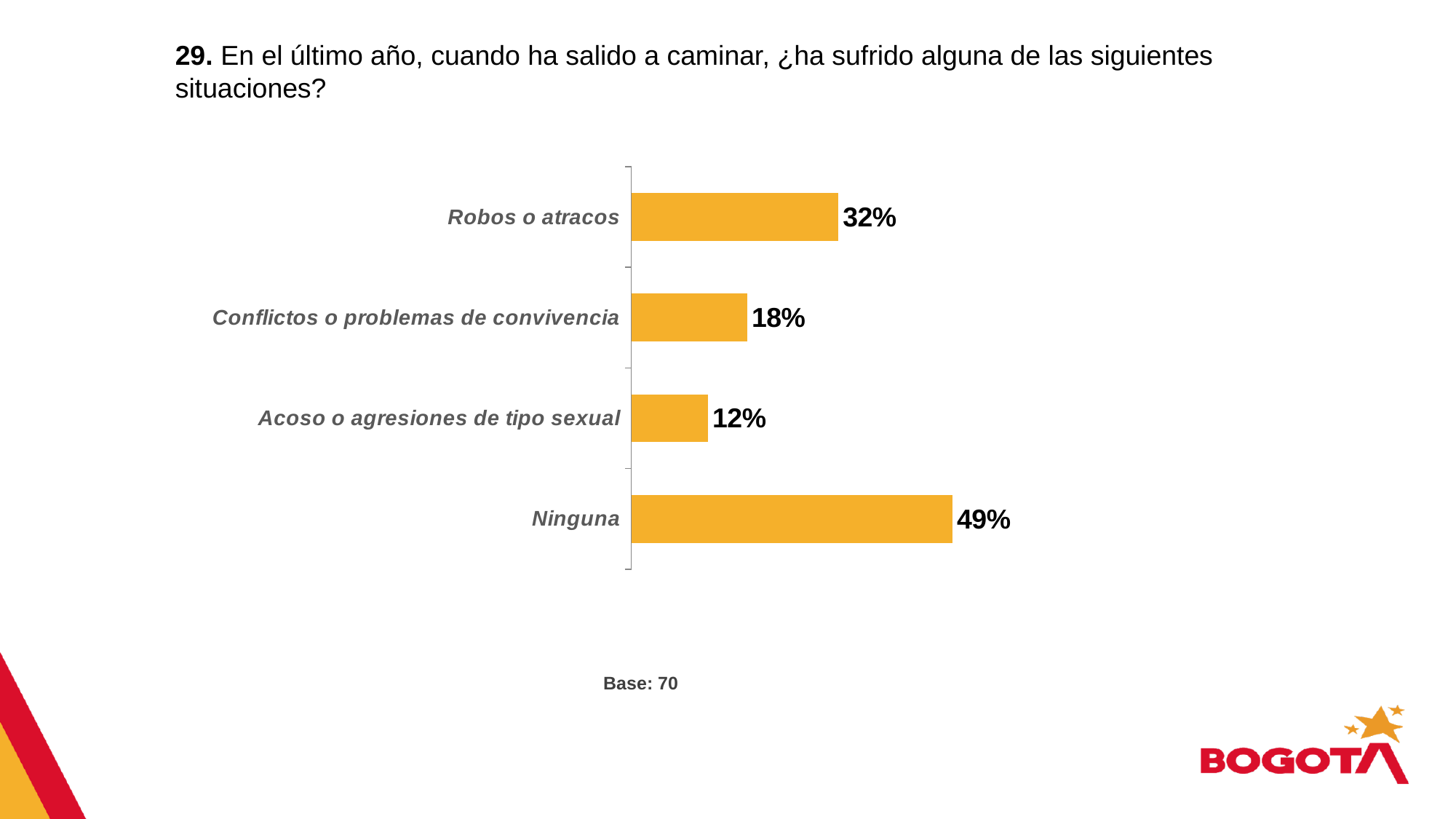
What is the value for Conflictos o problemas de convivencia? 18% Which category has the lowest value? Acoso o agresiones de tipo sexual What base (number of respondents) is stated below the chart? Base: 70 Which is larger, the value for Robos o atracos or the value for Conflictos o problemas de convivencia? Robos o atracos What is the difference between the values for Ninguna and Robos o atracos? 17% What is the value for Acoso o agresiones de tipo sexual? 12% What kind of chart is shown on the slide? Bar chart What is the value for Ninguna? 49% What is the difference between the values for Conflictos o problemas de convivencia and Acoso o agresiones de tipo sexual? 6% How many categories are shown in the chart? 4 What is the value for Robos o atracos? 32% Which category has the highest value? Ninguna